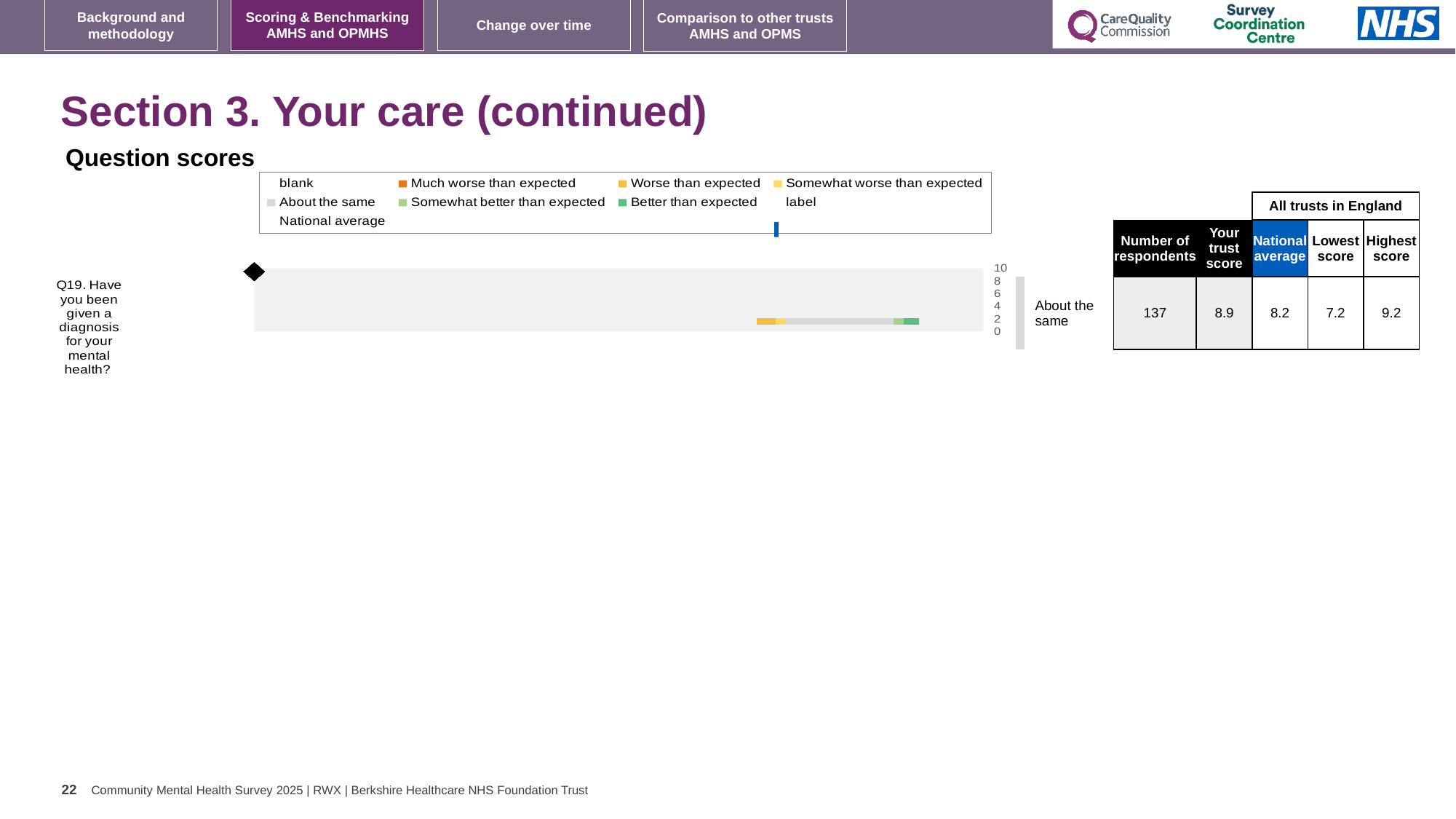
What benchmark category label is shown next to the bar for Q19? About the same Is your trust score for Q19 larger or smaller than the national average? larger In the table beside the chart, what is the national average for Q19? 8.2 In the table beside the chart, what is the lowest score among all trusts in England for Q19? 7.2 Which question is plotted in the question scores chart? Q19. Have you been given a diagnosis for your mental health? How many survey questions are plotted in the question scores chart? 1 In the table beside the chart, what is the highest score among all trusts in England for Q19? 9.2 What kind of chart is used to show the question score for Q19? bar chart What is the highest tick value shown on the chart's axis? 10 In the table beside the chart, what is your trust score for Q19? 8.9 In the table beside the chart, what is the number of respondents for Q19? 137 What is the difference between your trust score and the national average for Q19? 0.7